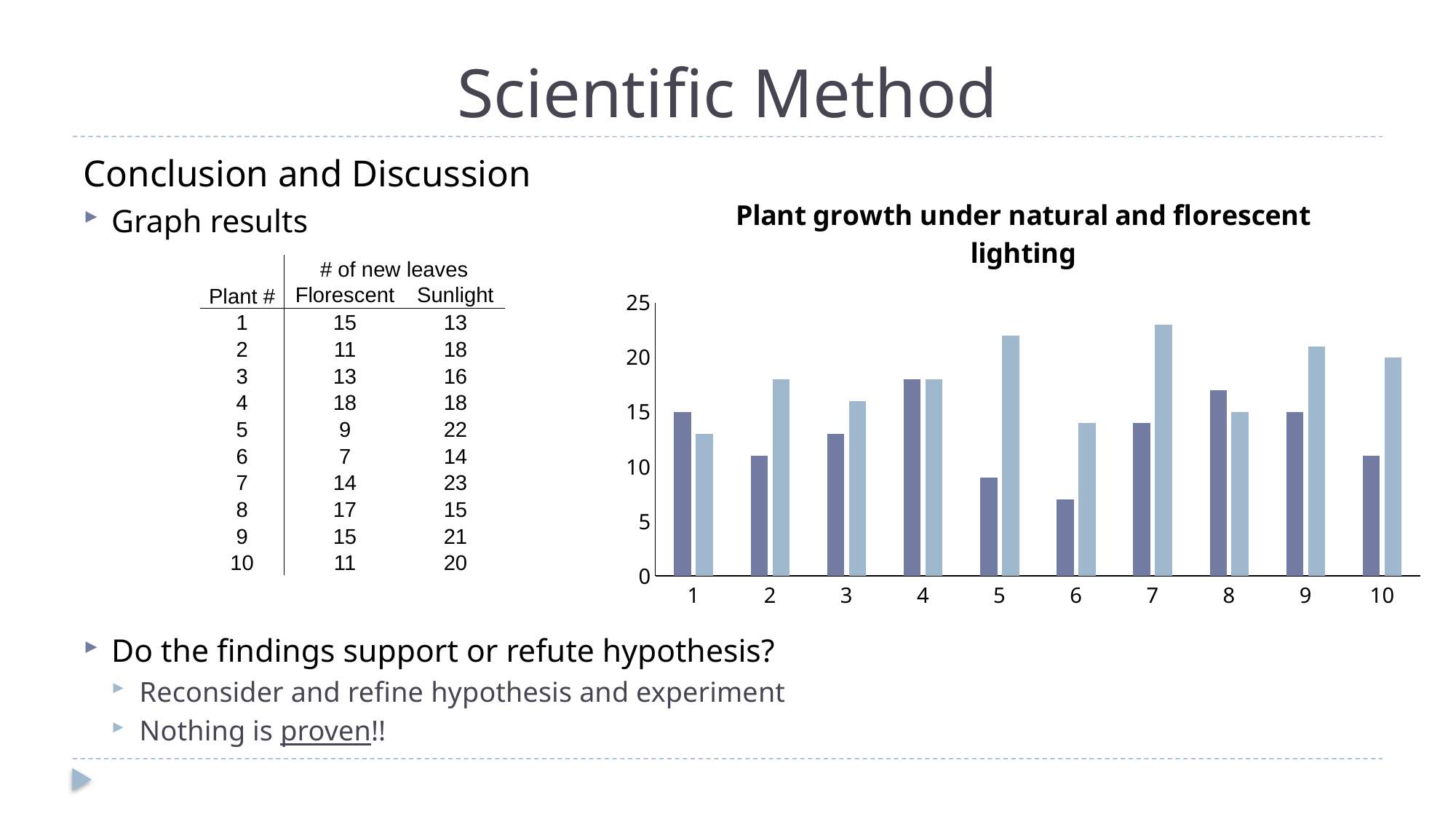
Which plant has the lowest darker bar in the chart? 6 What kind of chart is shown on the slide? bar chart Is the darker bar for plant 6 greater or less than 10? less Is the lighter bar for plant 7 greater or less than 20? greater For plant 8, which bar is taller, the darker bar or the lighter bar? the darker bar Is the darker bar for plant 5 greater or less than 10? less What value does the darker bar for plant 1 reach on the y axis? 15 How many bars are plotted for each plant in the chart? 2 What is the title of the chart? Plant growth under natural and florescent lighting How many plants (categories) are shown on the x axis of the chart? 10 What value does the lighter bar for plant 10 reach on the y axis? 20 For plant 2, which bar is taller, the darker bar or the lighter bar? the lighter bar